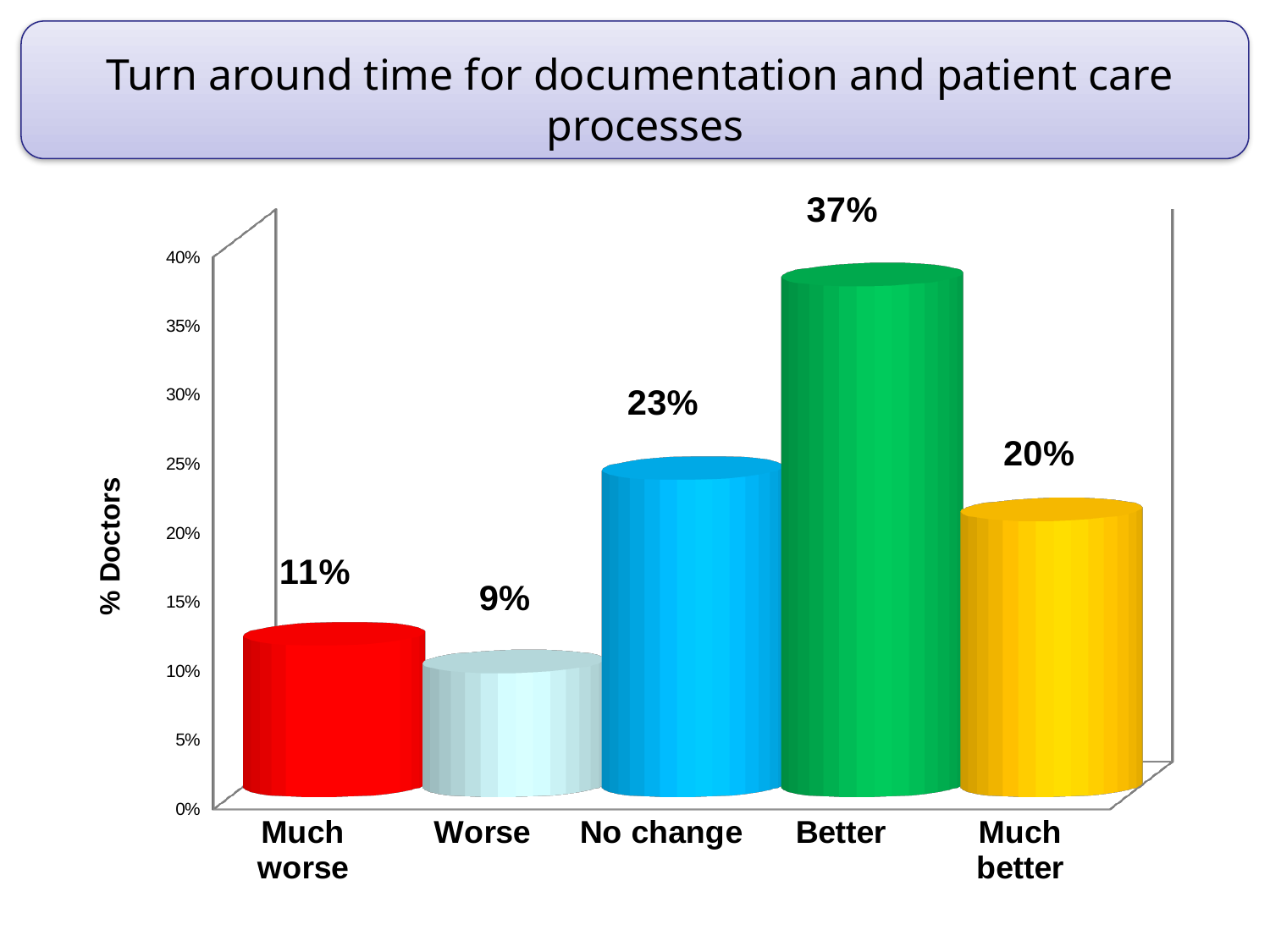
What percentage of doctors said 'Better'? 37% Which category has the lowest percentage of doctors? Worse What percentage of doctors said 'No change'? 23% What is the difference in percentage points between 'Better' and 'Much better'? 17 What kind of chart is shown on the slide? Bar chart How many categories are shown on the x axis? 5 What is the label of the vertical axis? % Doctors Which is larger, the value for 'No change' or the value for 'Much better'? No change What is the difference in percentage points between 'Much worse' and 'Worse'? 2 Is the value for 'Much better' greater or less than 15%? greater Which category has the highest percentage of doctors? Better What percentage of doctors said 'Much worse'? 11%